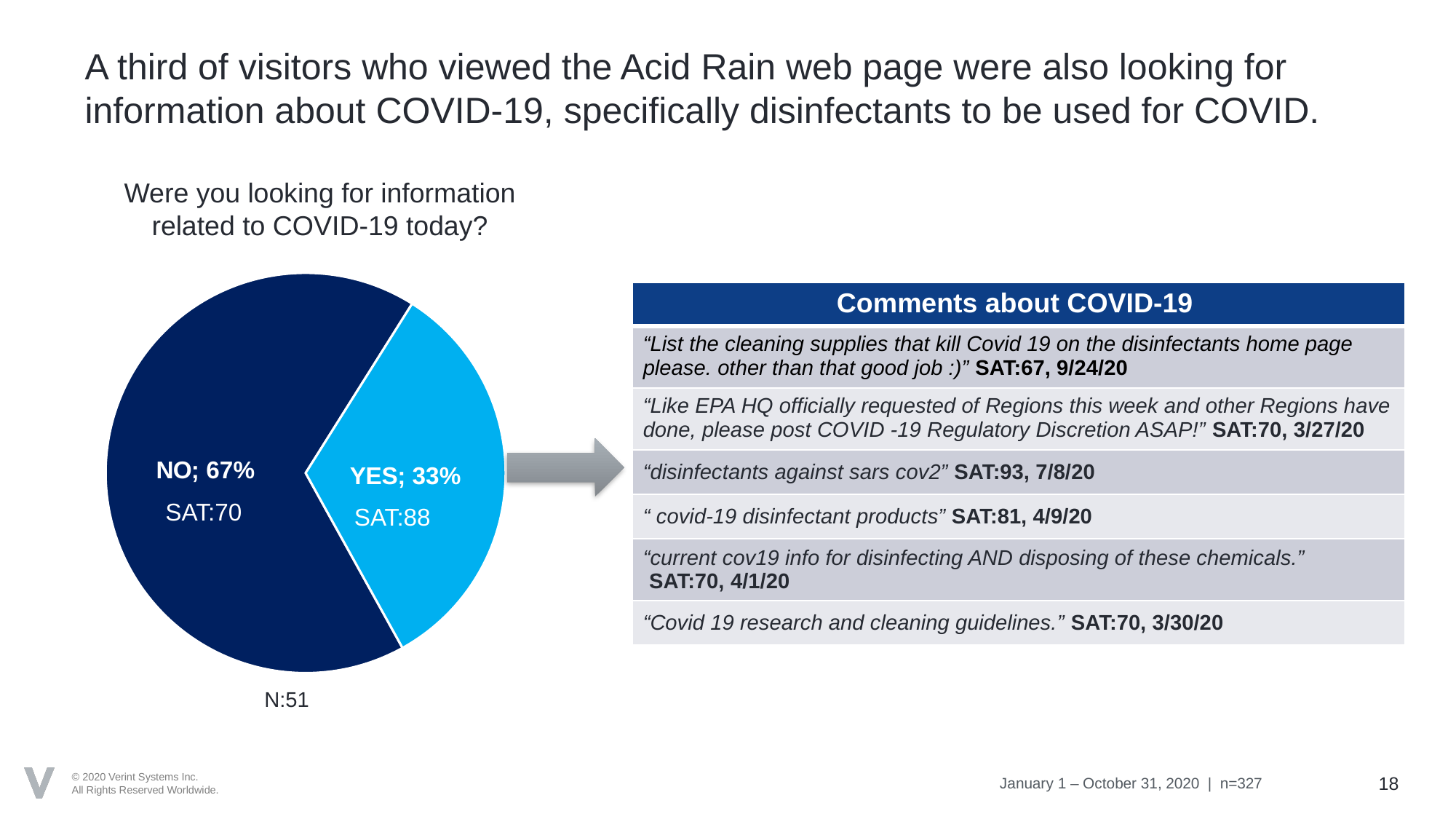
What percentage of respondents answered NO? 67% What is the SAT score shown for the YES slice? SAT:88 What is the SAT score shown for the NO slice? SAT:70 What is the difference in percentage points between the NO and YES slices? 34 How many slices does the pie chart have? 2 What is the N value shown below the pie chart? N:51 Which slice of the pie chart is the largest? NO What question is the pie chart titled with? Were you looking for information related to COVID-19 today? What type of chart is shown on the slide? pie chart What percentage of respondents answered YES? 33% Which is larger, the NO slice or the YES slice? NO Which slice of the pie chart is the smallest? YES